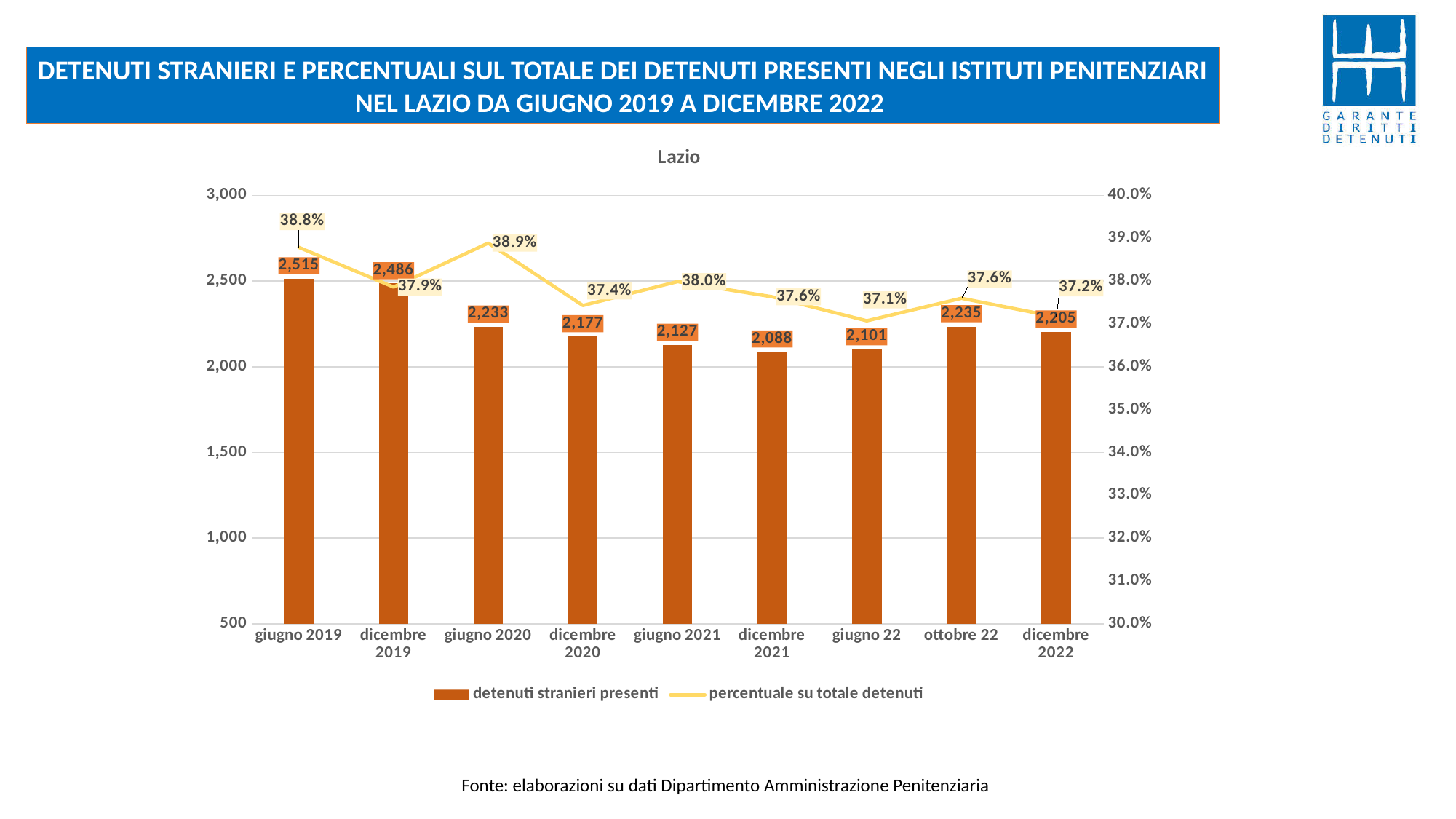
Which period has the lowest 'percentuale su totale detenuti'? giugno 22 What is the value of 'detenuti stranieri presenti' for giugno 2019? 2,515 What is the value of 'detenuti stranieri presenti' for ottobre 22? 2,235 What is the 'percentuale su totale detenuti' for giugno 2020? 38.9% How many series does the legend list? 2 What is the difference in 'detenuti stranieri presenti' between giugno 2019 and dicembre 2022? 310 Which is larger, the number of 'detenuti stranieri presenti' in giugno 2021 or in giugno 22? giugno 2021 Which period has the lowest number of 'detenuti stranieri presenti'? dicembre 2021 How many periods are shown on the x axis? 9 Which period has the highest number of 'detenuti stranieri presenti'? giugno 2019 What kind of chart is shown on the slide? Combined bar and line chart What is the title shown above the chart area? Lazio